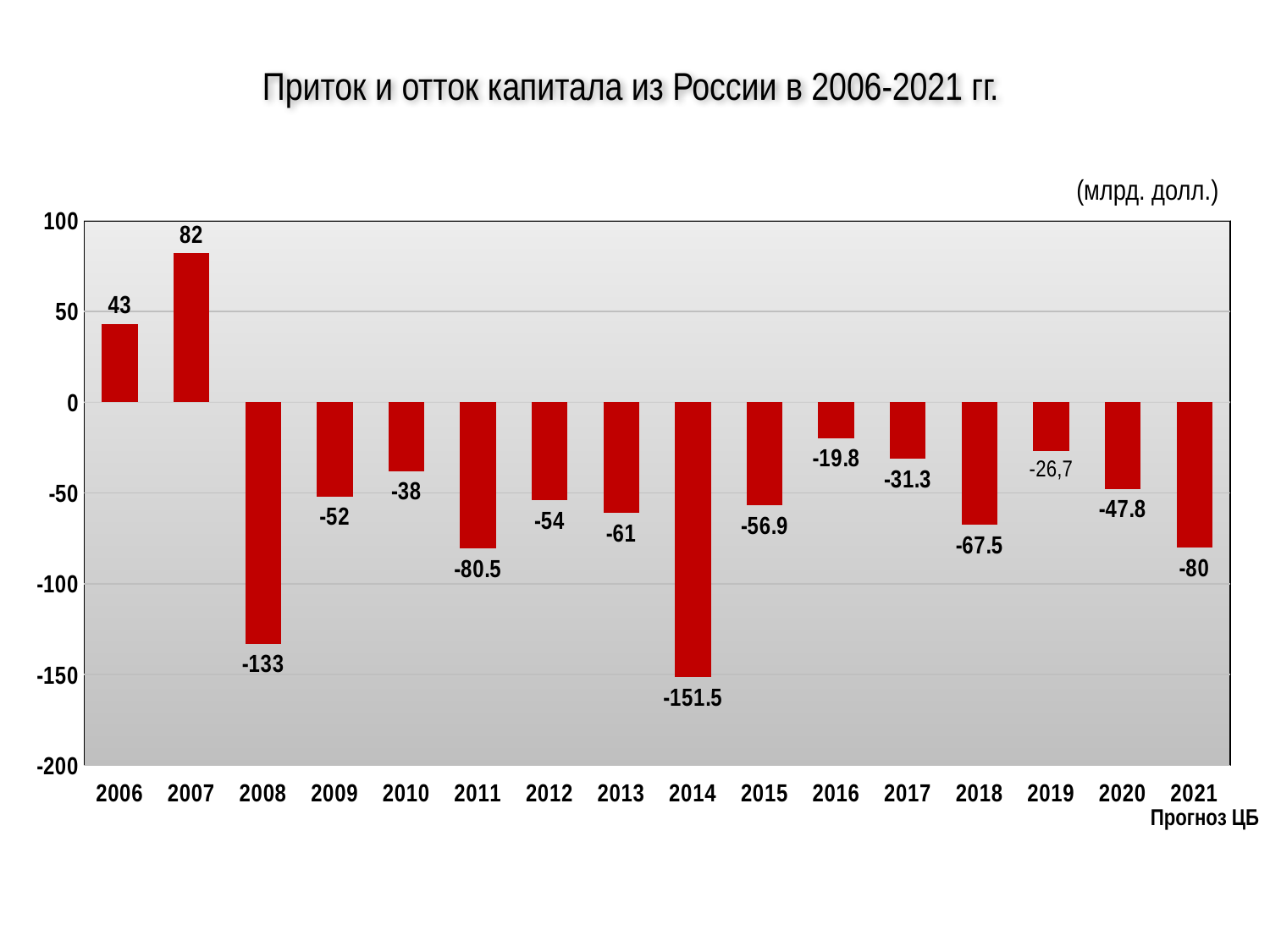
Is the value for 2008 greater or less than -100? less What is the value for 2014? -151.5 What is the value for 2019? -26,7 What is the value for 2007? 82 How many years are shown on the x axis? 16 What is the difference between the values for 2007 and 2006? 39 Which year has the lowest value? 2014 Which is larger, the value for 2016 or the value for 2017? 2016 What kind of chart is this? bar chart Which year has the highest value? 2007 What unit is indicated above the chart? млрд. долл. What is the title of the chart? Приток и отток капитала из России в 2006-2021 гг.